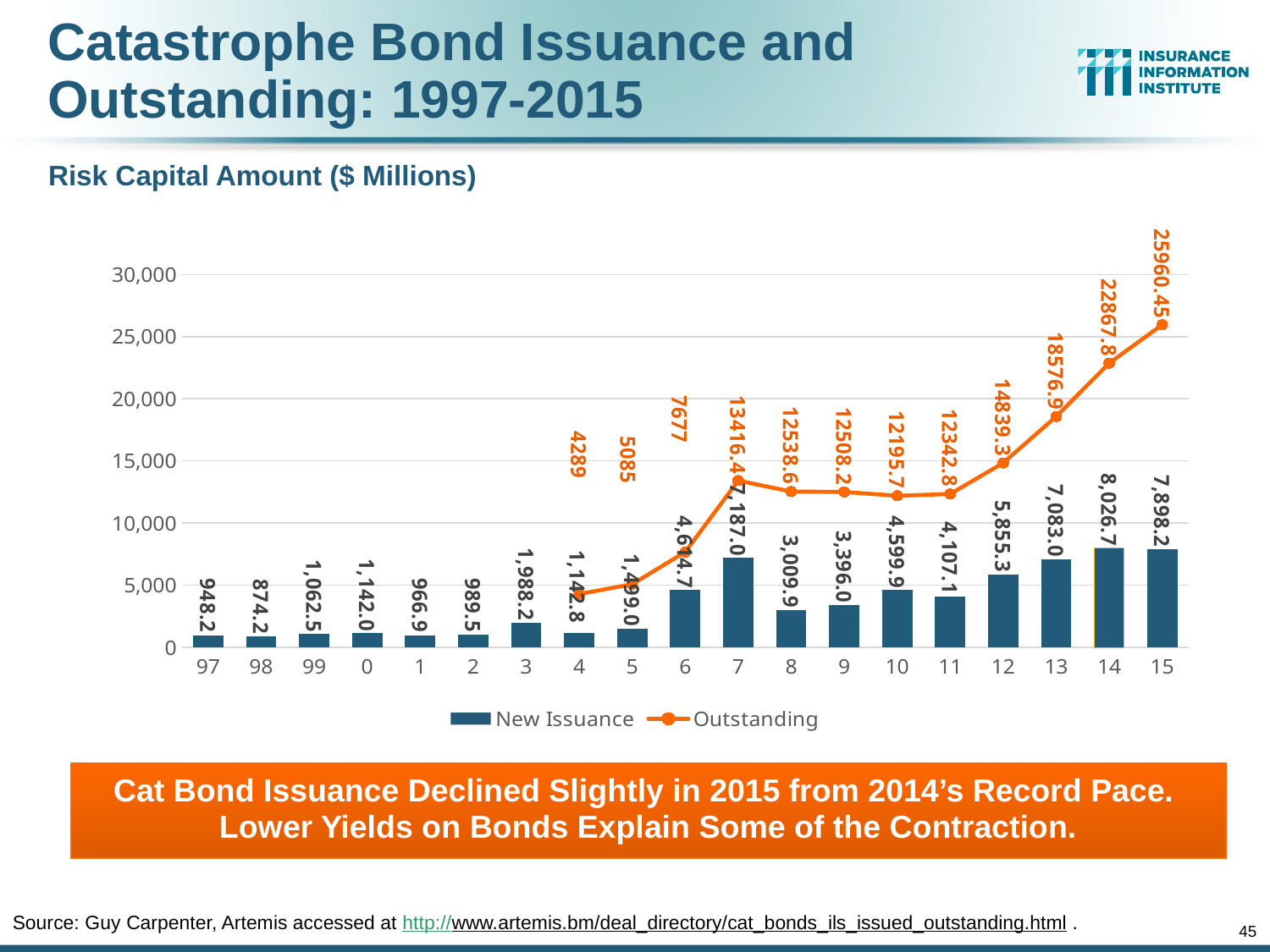
What is the New Issuance value for 14? 8,026.7 What is the Outstanding value for 15? 25960.45 Which year has the highest New Issuance value? 14 What is the New Issuance value for 97? 948.2 Which is larger, the New Issuance value for 7 or for 13? 7 What is the Outstanding value for 7? 13416.4 What is the difference between the New Issuance values for 14 and 15? 128.5 How many series does the legend list? 2 Which year has the lowest New Issuance value? 98 Which year has the lowest Outstanding value? 4 Does the Outstanding line rise or fall from 12 to 15? rise How many years are shown on the x axis? 19